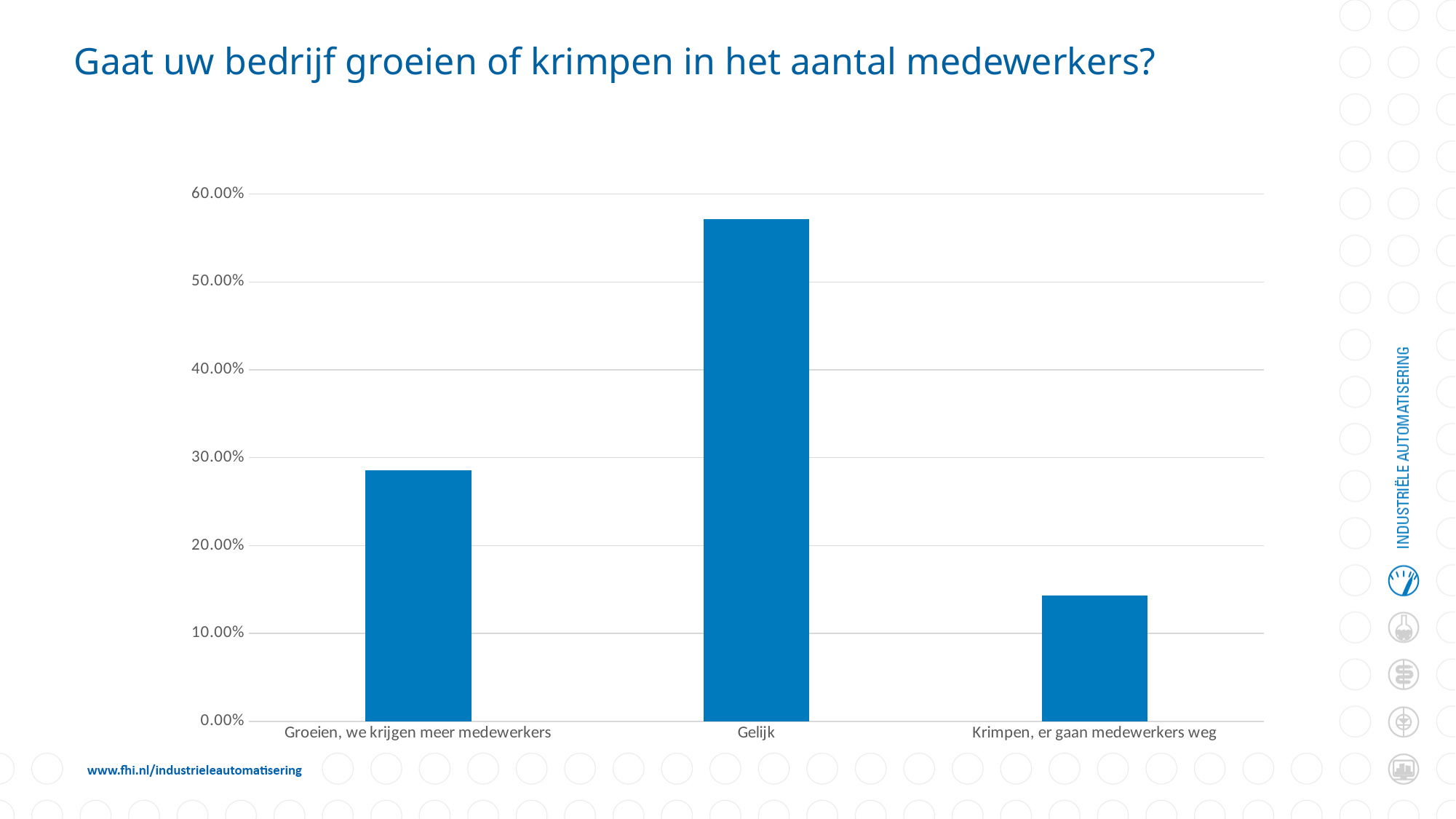
Which is larger: the value for 'Gelijk' or the value for 'Groeien, we krijgen meer medewerkers'? Gelijk Is the value for 'Gelijk' greater or less than 60.00%? less What is the highest value shown on the y axis of the chart? 60.00% Which is larger: the value for 'Groeien, we krijgen meer medewerkers' or the value for 'Krimpen, er gaan medewerkers weg'? Groeien, we krijgen meer medewerkers Which category has the highest bar? Gelijk Is the value for 'Krimpen, er gaan medewerkers weg' greater or less than 10.00%? greater Is the value for 'Groeien, we krijgen meer medewerkers' greater or less than 30.00%? less What is the title of the slide above the chart? Gaat uw bedrijf groeien of krimpen in het aantal medewerkers? What kind of chart is shown on the slide? bar chart How many categories are shown on the x axis of the chart? 3 Which category has the lowest bar? Krimpen, er gaan medewerkers weg